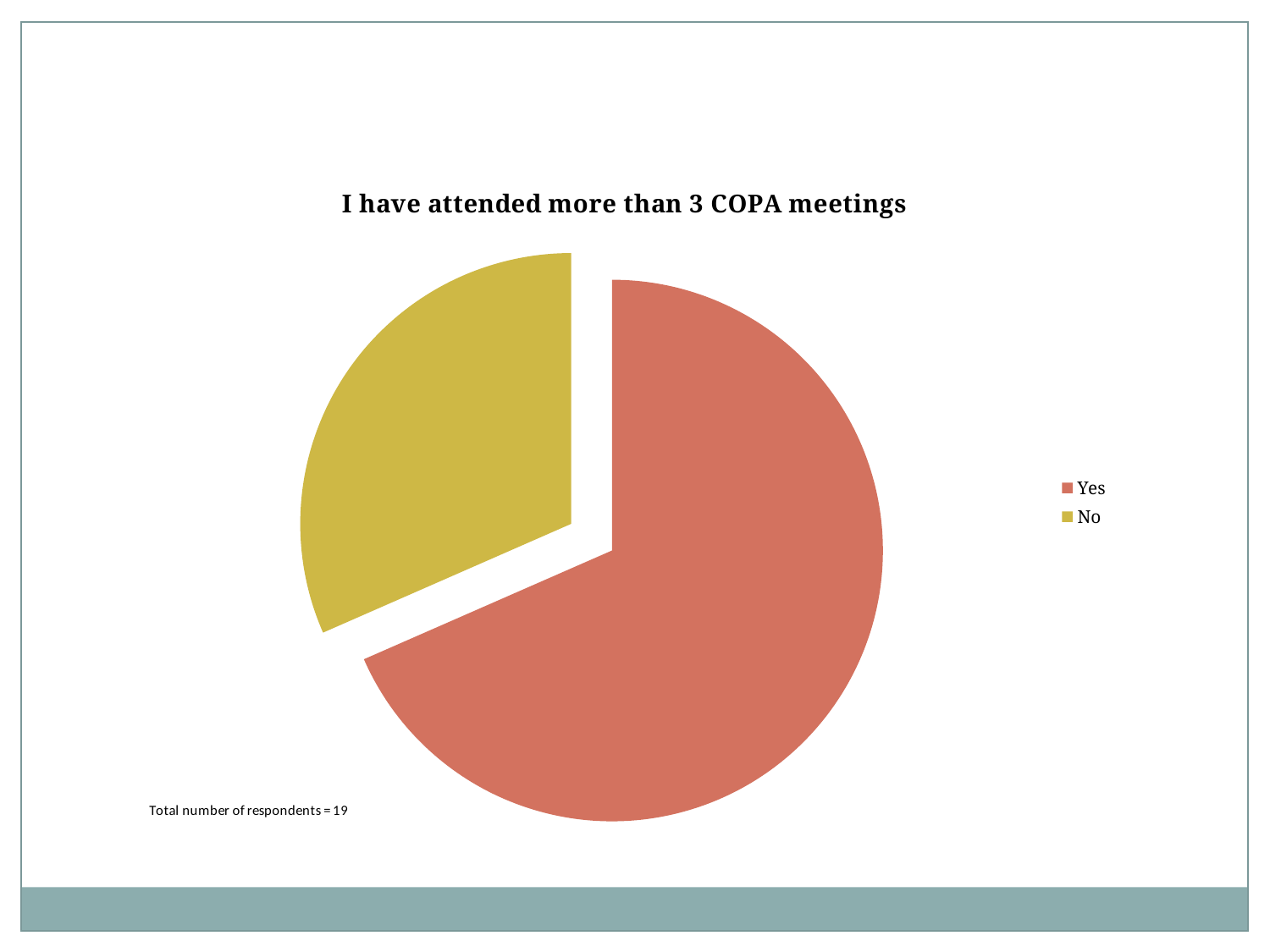
Which category has the smallest slice of the pie? No Which category has the largest slice of the pie? Yes How many entries does the legend list? 2 Which colour represents the "No" category in the pie chart? yellow What kind of chart is shown on the slide? pie chart According to the note on the slide, what is the total number of respondents? 19 How many slices does the pie chart have? 2 What is the title of the chart? I have attended more than 3 COPA meetings Which slice is larger, Yes or No? Yes